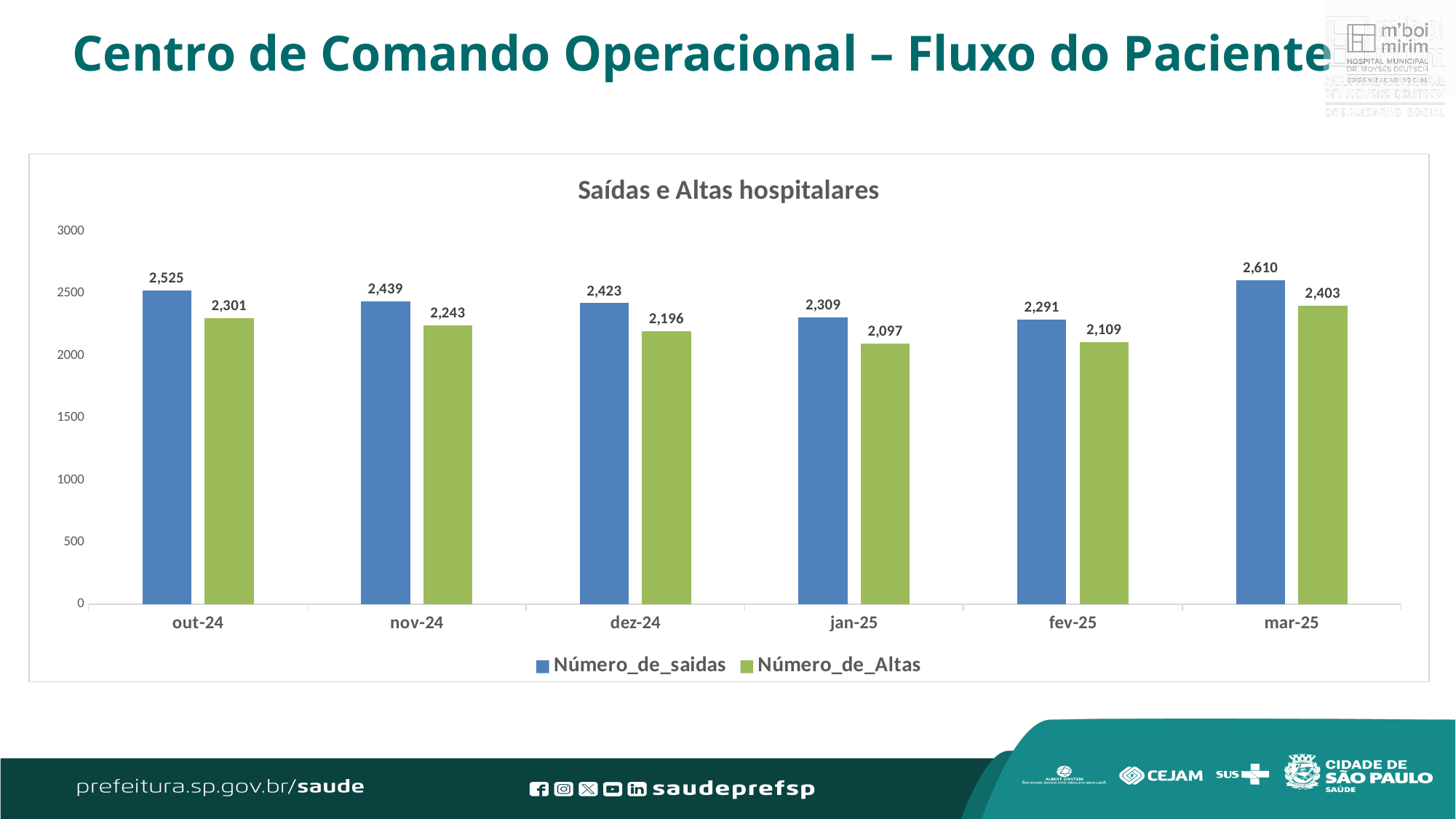
What is the title of the chart? Saídas e Altas hospitalares Which is larger: Número_de_saidas in nov-24 or Número_de_saidas in fev-25? Número_de_saidas in nov-24 How many series does the legend list? 2 What is the difference between Número_de_saidas and Número_de_Altas in dez-24? 227 Which month has the highest value for Número_de_saidas? mar-25 Which month has the lowest value for Número_de_Altas? jan-25 What is the value of Número_de_saidas for out-24? 2,525 How many months are shown on the x axis? 6 What is the value of Número_de_Altas for mar-25? 2,403 What kind of chart is shown? bar chart Is the value of Número_de_Altas for fev-25 greater or less than 2500? less What is the value of Número_de_Altas for jan-25? 2,097